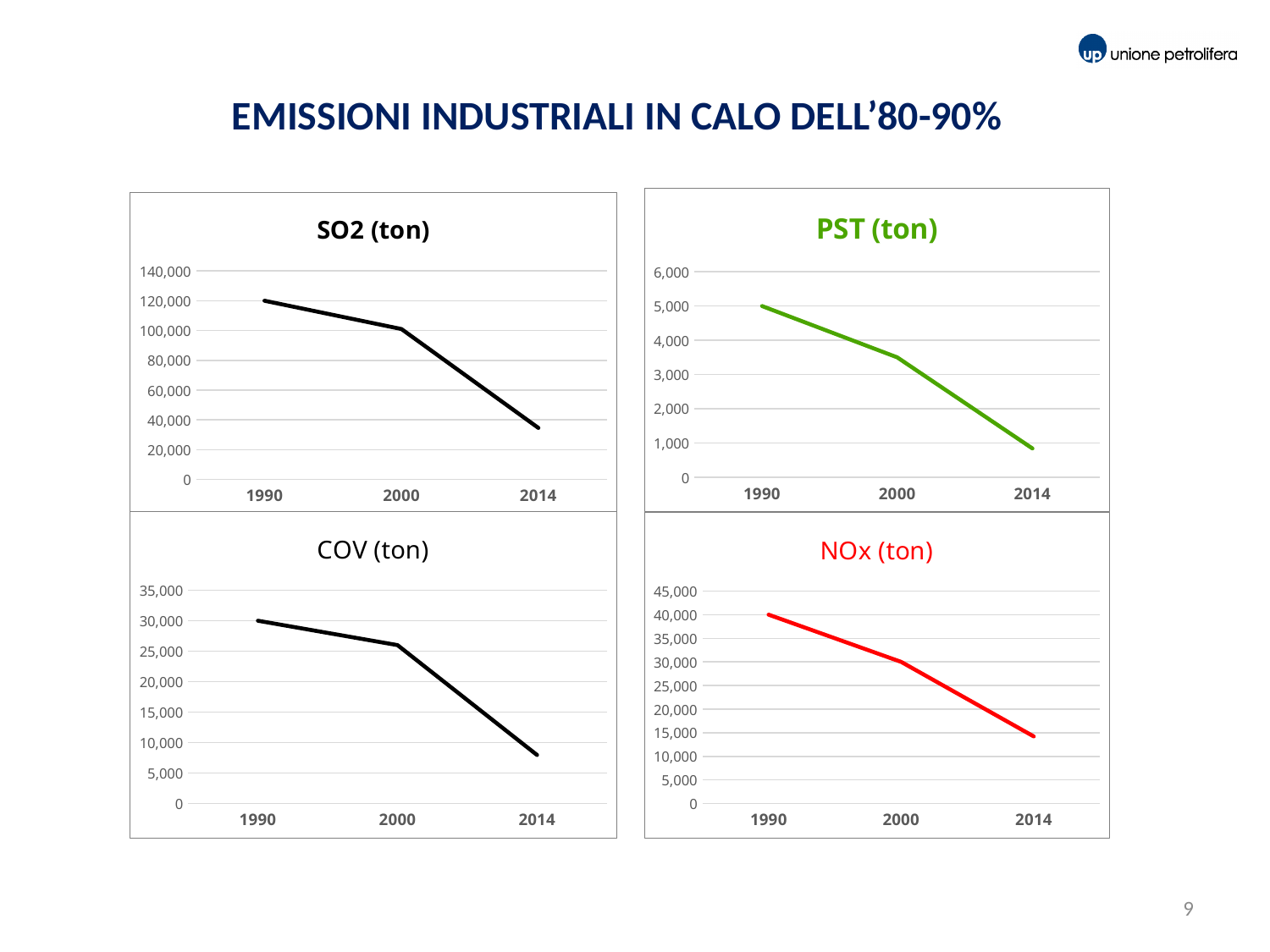
In the COV (ton) chart, which year has the lowest value? 2014 In the SO2 (ton) chart, is the value for 2014 greater or less than 40,000? less In the SO2 (ton) chart, do the values rise or fall from 1990 to 2014? fall What colour is the line in the PST (ton) chart? green What kind of chart is the SO2 (ton) chart? line chart In the NOx (ton) chart, which year has the highest value? 1990 In the NOx (ton) chart, is the value for 2014 greater or less than 20,000? less In the PST (ton) chart, is the value for 2014 greater or less than 1,000? less How many years are plotted on the x axis of the PST (ton) chart? 3 In the SO2 (ton) chart, what is the value for 1990? 120,000 In the PST (ton) chart, what is the value for 1990? 5,000